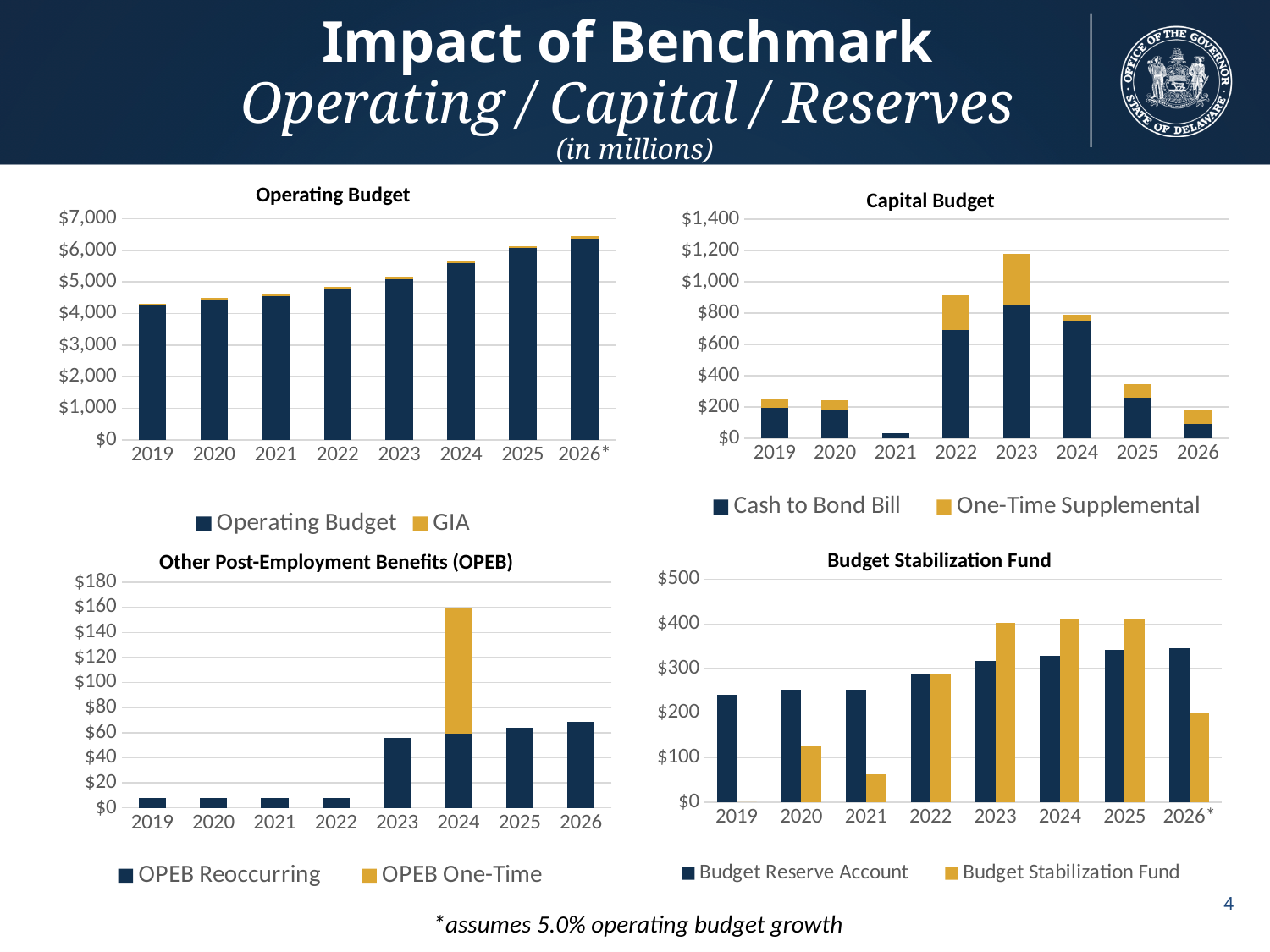
In the Capital Budget chart, which year has the lowest total bar? 2021 In the Operating Budget chart, do the bar totals rise or fall from 2019 to 2026*? rise In the Budget Stabilization Fund chart, which is larger in 2020: Budget Reserve Account or Budget Stabilization Fund? Budget Reserve Account In the Capital Budget chart, how many series does the legend list? 2 In the Other Post-Employment Benefits (OPEB) chart, which year has the highest total bar? 2024 In the Capital Budget chart, is the total for 2023 greater or less than $1,000? greater In the Other Post-Employment Benefits (OPEB) chart, is the total for 2019 greater or less than $20? less In the Capital Budget chart, which year has the highest total bar? 2023 In the Operating Budget chart, is the total for 2019 greater or less than $5,000? less In the Operating Budget chart, how many years are shown on the x axis? 8 What kind of chart is the Budget Stabilization Fund chart? bar chart